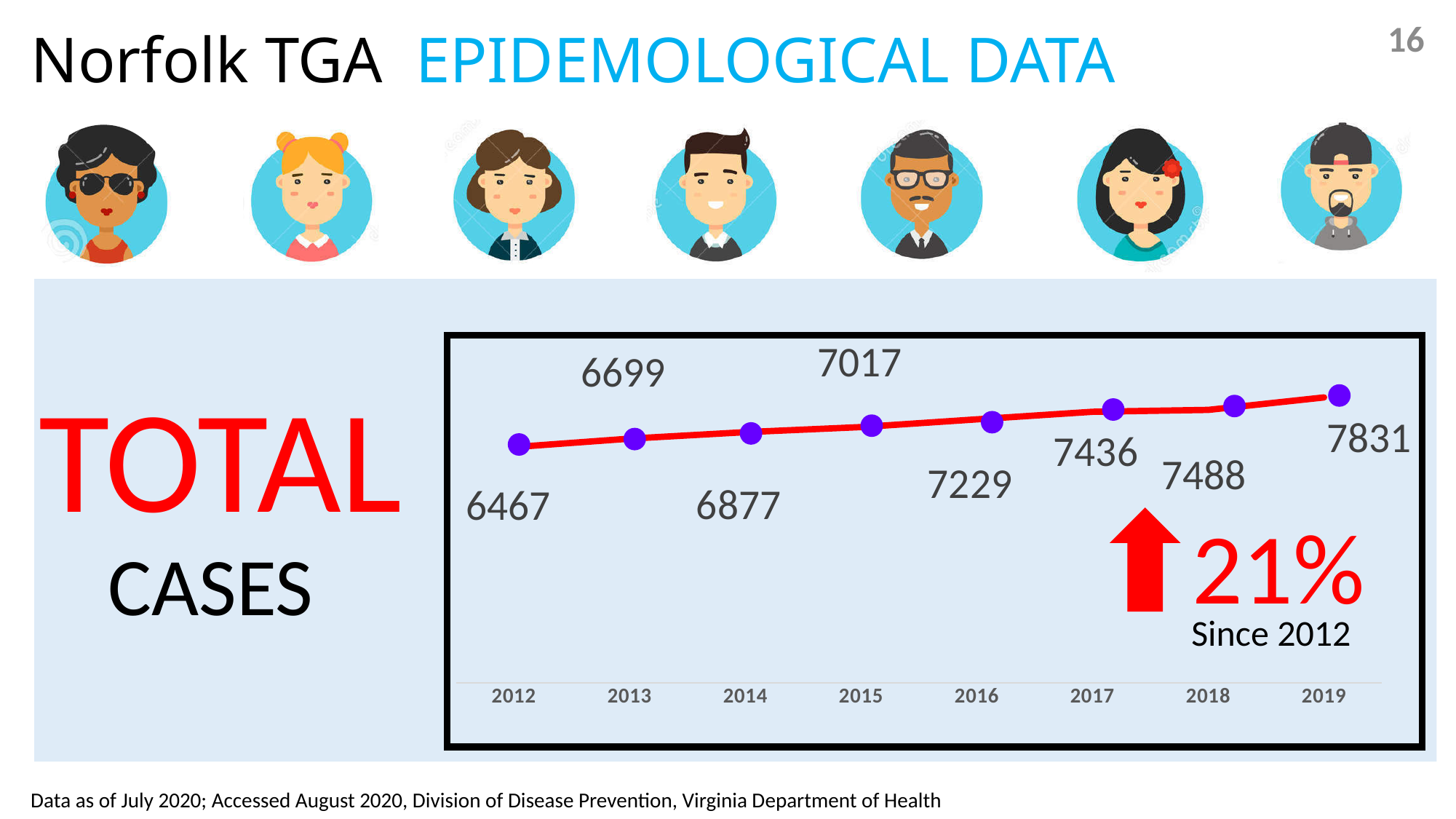
What is the value for 2016? 7229 Which year has the lowest value? 2012 What is the value for 2019? 7831 Which is larger, the value for 2015 or the value for 2013? 2015 What kind of chart is shown? line chart What is the value for 2012? 6467 How many years are plotted on the chart? 8 What is the difference between the values for 2018 and 2017? 52 Do the values rise or fall from 2012 to 2019? rise What is the difference between the values for 2019 and 2012? 1364 What is the value for 2014? 6877 Which year has the highest value? 2019